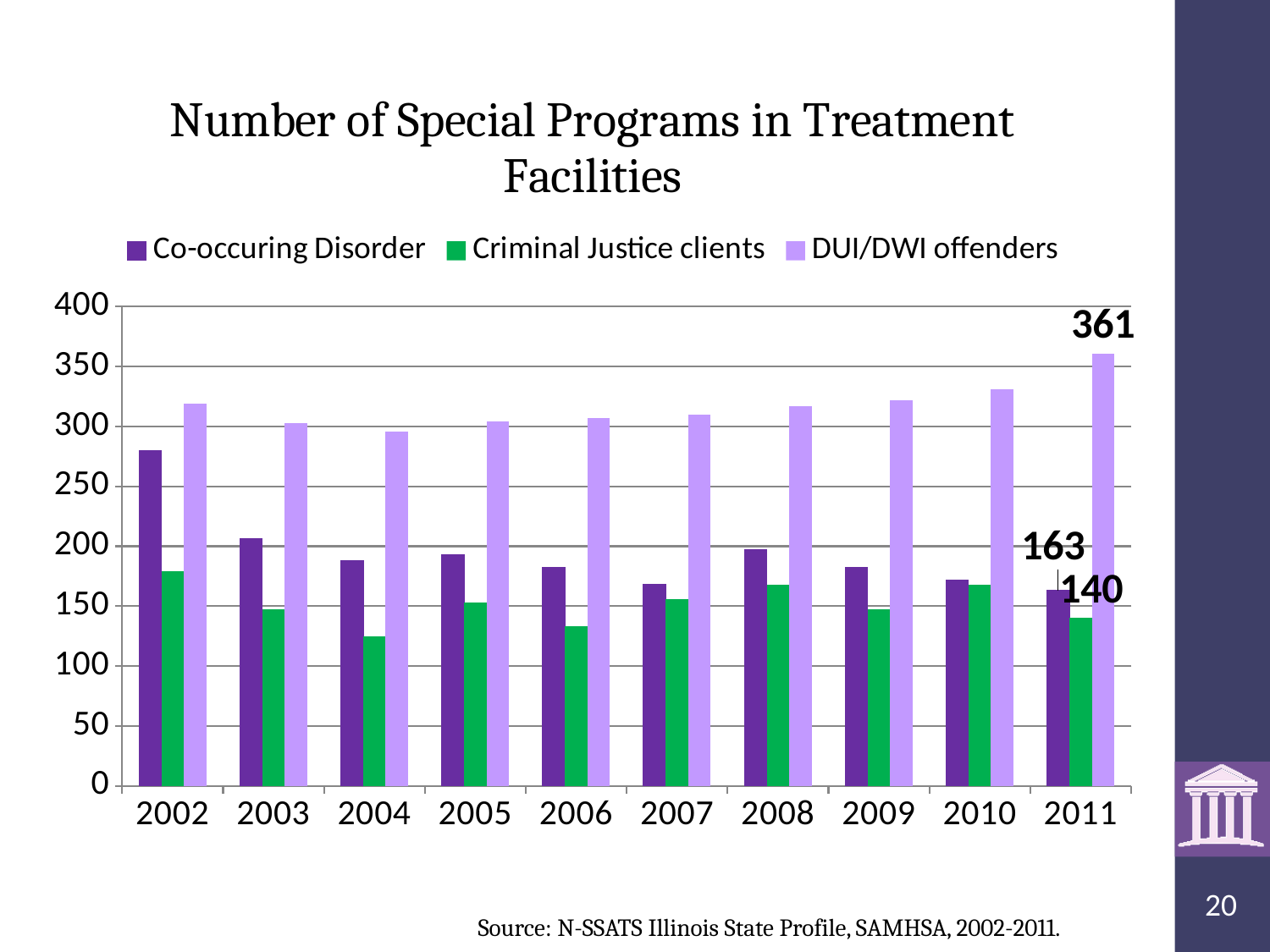
Is the value for Criminal Justice clients in 2004 greater or less than 150? less What is the value for Criminal Justice clients in 2011? 140 How many years are shown on the x axis? 10 Does the Co-occuring Disorder value rise or fall from 2002 to 2011? fall In 2011, what is the difference between the DUI/DWI offenders value and the Co-occuring Disorder value? 198 What is the value for Co-occuring Disorder in 2011? 163 Is the value for Co-occuring Disorder in 2002 greater or less than 250? greater In 2011, how much larger is the Co-occuring Disorder value than the Criminal Justice clients value? 23 How many series does the legend list? 3 Which series has the highest value in 2011? DUI/DWI offenders In which year is the Co-occuring Disorder value the highest? 2002 What is the value for DUI/DWI offenders in 2011? 361